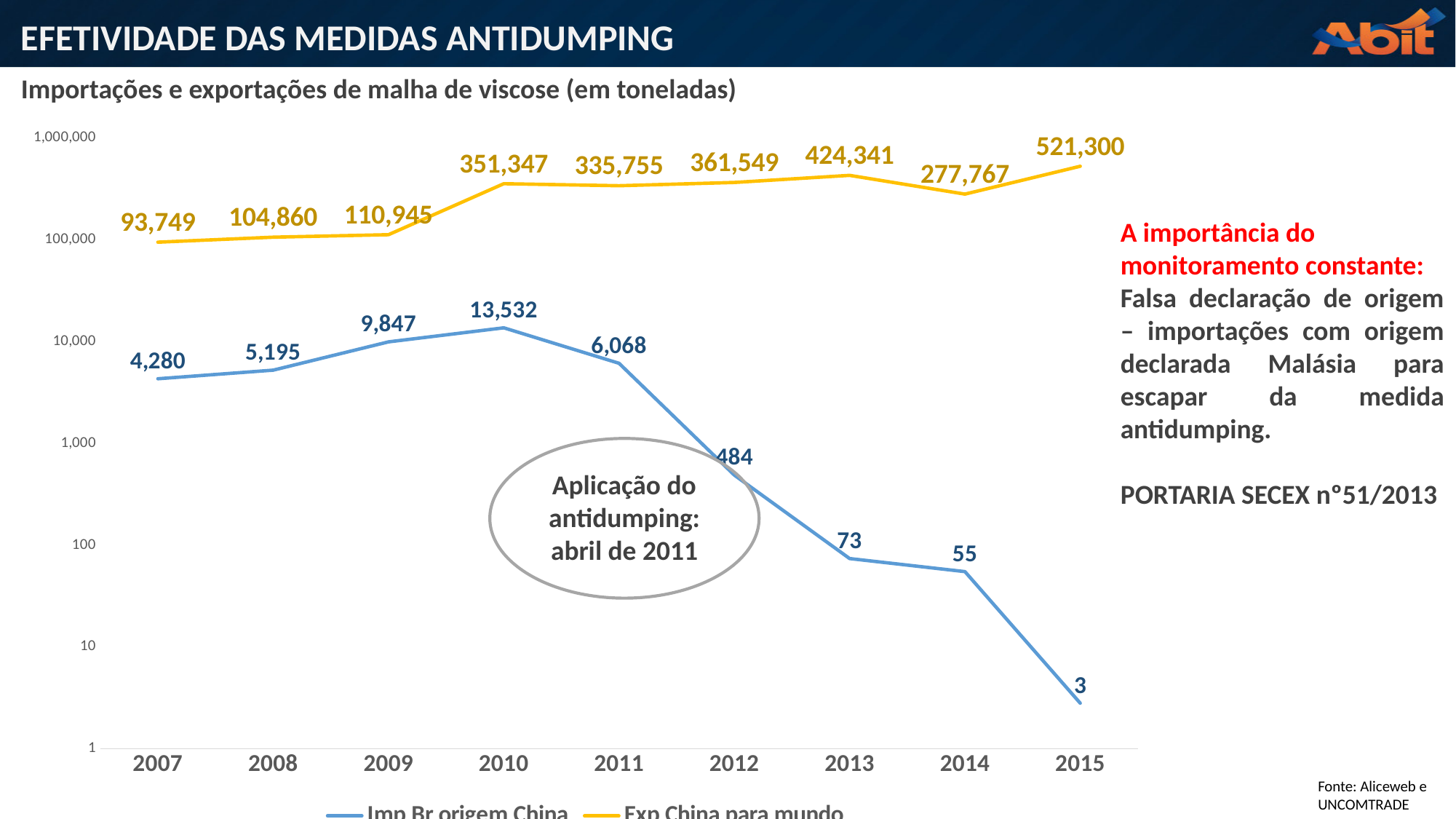
What is the value for Imp Br origem China in 2015? 3 What is the difference between Imp Br origem China in 2010 and 2011? 7,464 Does Imp Br origem China rise or fall from 2011 to 2015? fall What is the value for Exp China para mundo in 2015? 521,300 What type of chart is shown on the slide? line chart What is the title of the chart? Importações e exportações de malha de viscose (em toneladas) How many years are shown on the x axis? 9 How many series does the legend list? 2 Which is larger for Exp China para mundo: 2013 or 2014? 2013 In which year is Imp Br origem China highest? 2010 In which year is Exp China para mundo lowest? 2007 What is the value for Imp Br origem China in 2010? 13,532